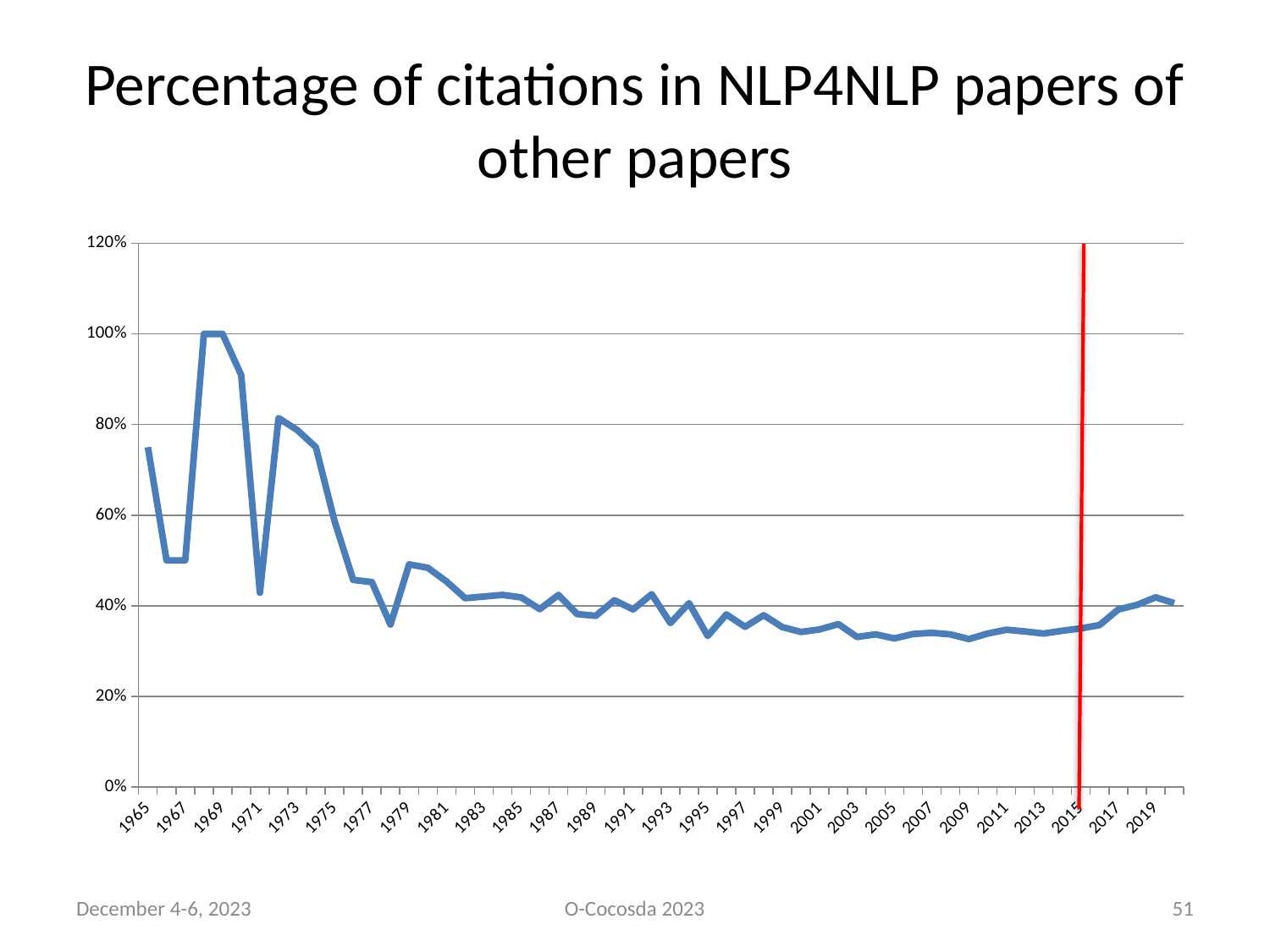
What is the highest value reached by the line? 100% Which year has the larger value, 1965 or 2005? 1965 What kind of chart is shown on the slide? line chart What is the title of the chart? Percentage of citations in NLP4NLP papers of other papers Is the value for 1978 greater or less than 40%? less Is the value for 2019 greater or less than 60%? less Is the value for 1972 greater or less than 60%? greater Overall, do the values rise or fall from 1965 to 2015? fall Which year has the larger value, 1969 or 1971? 1969 What is the value for 1969? 100%